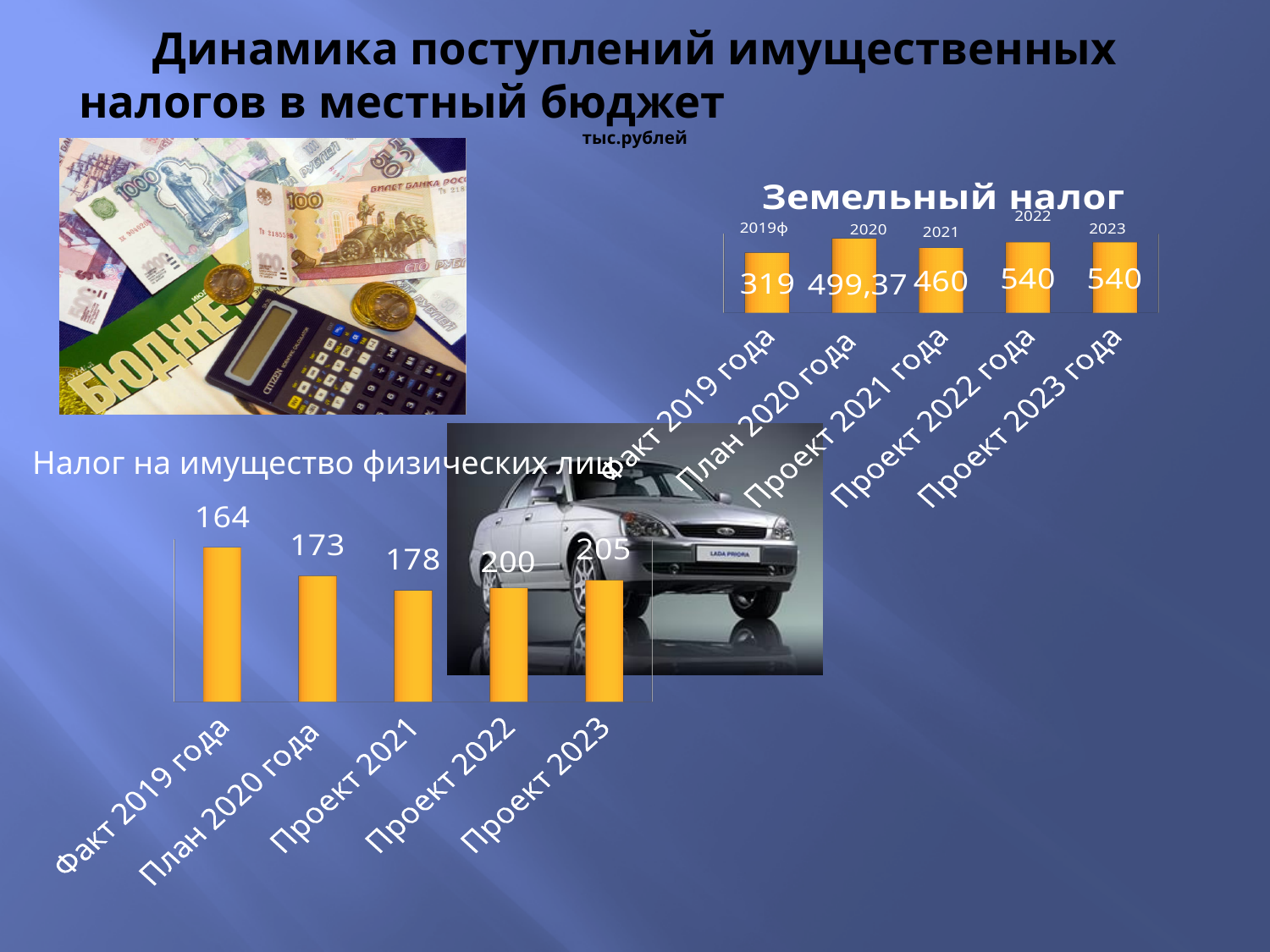
In the 'Земельный налог' chart, what is the value for Факт 2019 года? 319 In the 'Земельный налог' chart, what is the difference between Проект 2022 года and Проект 2021 года? 80 In the 'Налог на имущество физических лиц' chart, what is the difference between Проект 2022 and План 2020 года? 27 In the 'Земельный налог' chart, what is the value for Проект 2021 года? 460 In the 'Земельный налог' chart, what is the value for План 2020 года? 499,37 What kind of chart is the 'Налог на имущество физических лиц' chart? bar chart In the 'Земельный налог' chart, which category has the lowest value? Факт 2019 года In the 'Земельный налог' chart, how many categories are shown? 5 In the 'Налог на имущество физических лиц' chart, what is the value for Факт 2019 года? 164 In the 'Налог на имущество физических лиц' chart, what is the value for Проект 2023? 205